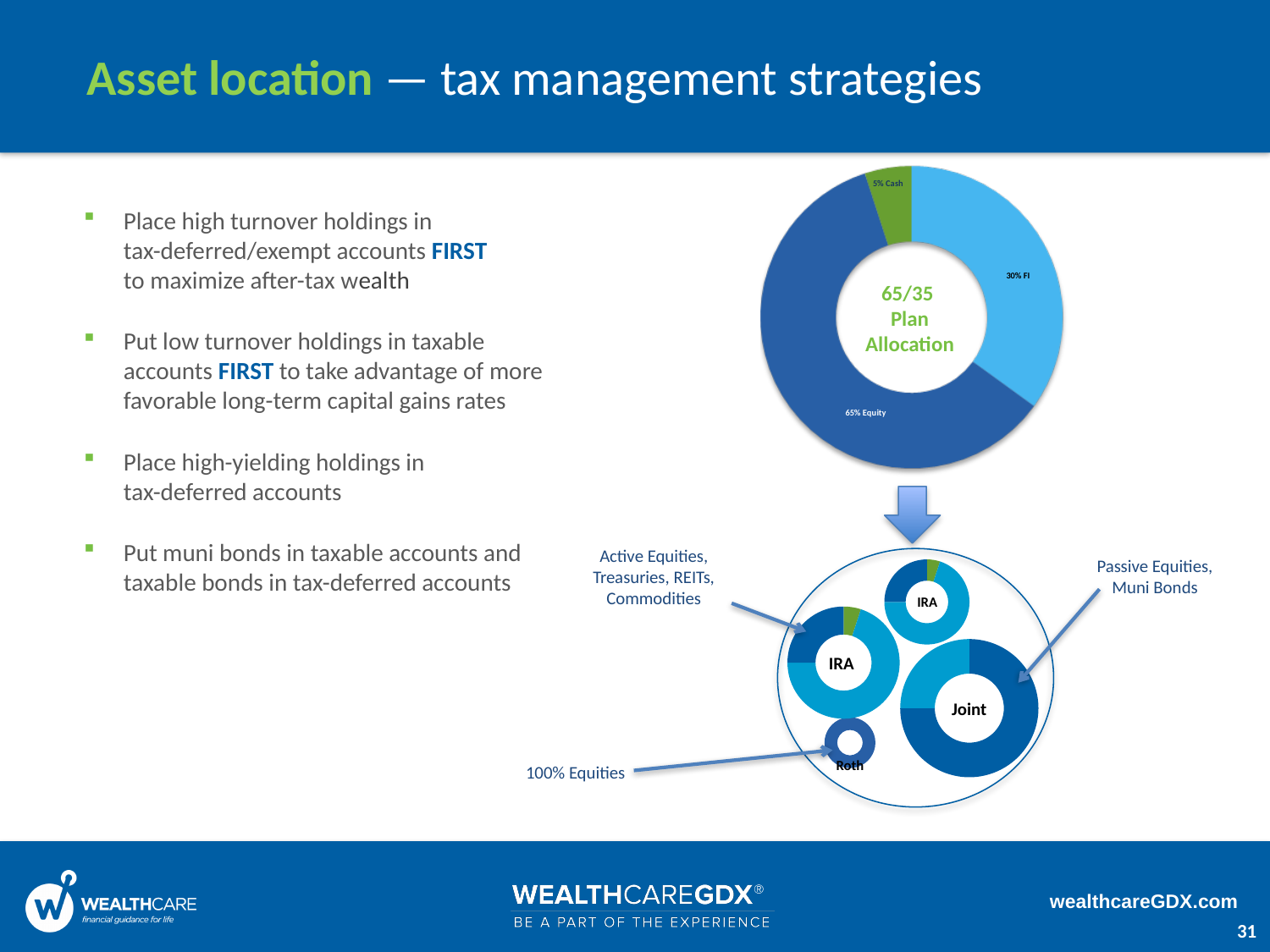
How many slices does the 65/35 Plan Allocation chart have? 3 In the 65/35 Plan Allocation chart, what share is labelled for FI? 30% In the 65/35 Plan Allocation chart, how many percentage points larger is the Equity slice than the FI slice? 35 In the 65/35 Plan Allocation chart, what do the FI and Cash slices add up to? 35% In the 65/35 Plan Allocation chart, which category has the smallest slice? Cash What kind of chart is the 65/35 Plan Allocation chart? Pie (donut) chart In the 65/35 Plan Allocation chart, which slice is larger, FI or Cash? FI In the 65/35 Plan Allocation chart, which category has the largest slice? Equity What text is printed in the centre of the large donut chart? 65/35 Plan Allocation How many small donut charts are shown inside the large circle below the arrow? 4 In the 65/35 Plan Allocation chart, what share is labelled for Equity? 65% In the 65/35 Plan Allocation chart, what share is labelled for Cash? 5%